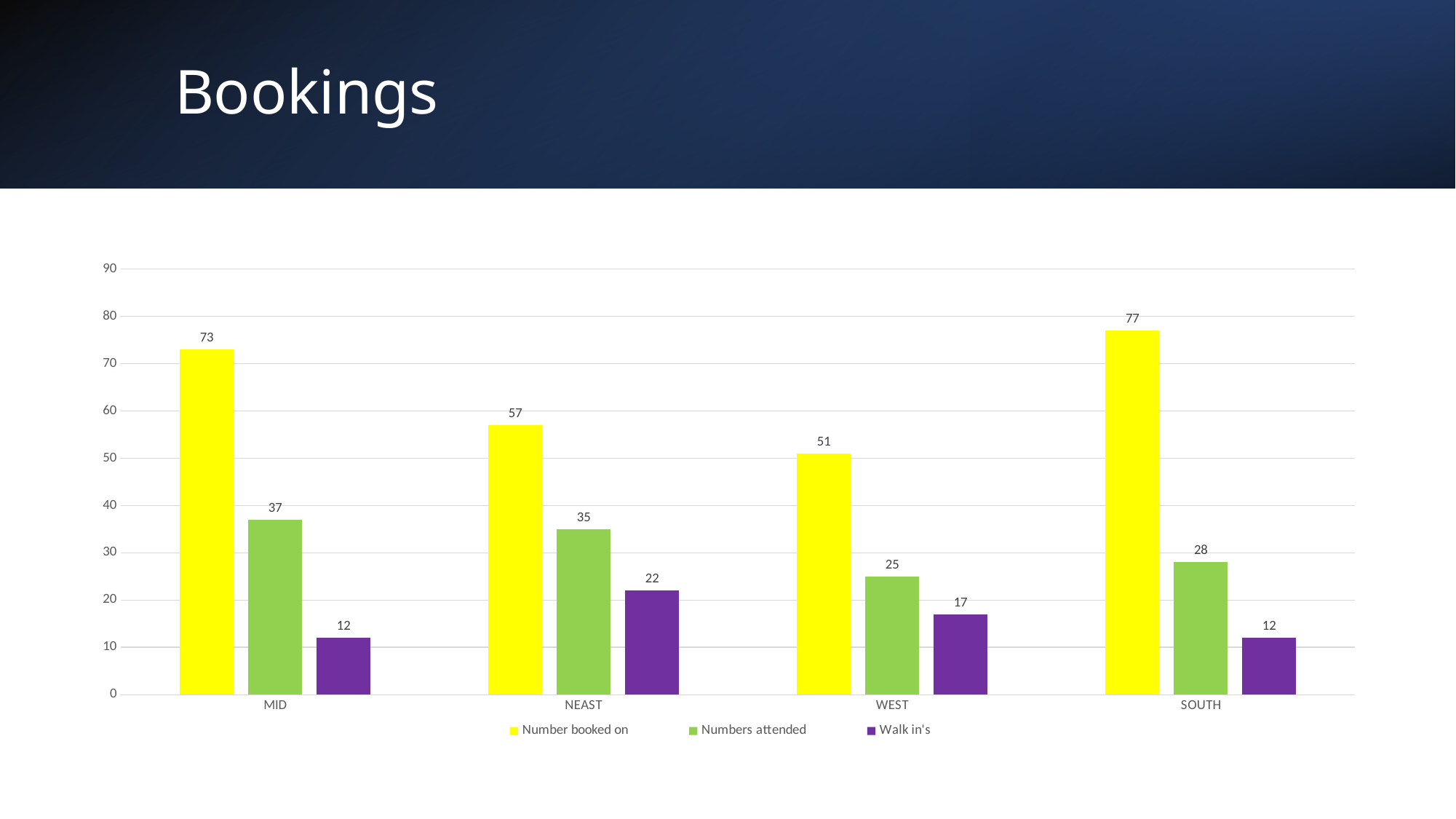
Which region has the lowest value for Numbers attended? WEST What is the value of Numbers attended for WEST? 25 Is the value of Number booked on for WEST greater or less than 60? less What colour are the Walk in's bars? purple What is the difference between Number booked on and Numbers attended for SOUTH? 49 How many regions are shown on the x axis? 4 Which is larger, Walk in's for NEAST or Walk in's for WEST? NEAST What is the value of Number booked on for MID? 73 How many series does the legend list? 3 What kind of chart is shown on the slide? bar chart Which region has the highest value for Number booked on? SOUTH What is the value of Walk in's for NEAST? 22